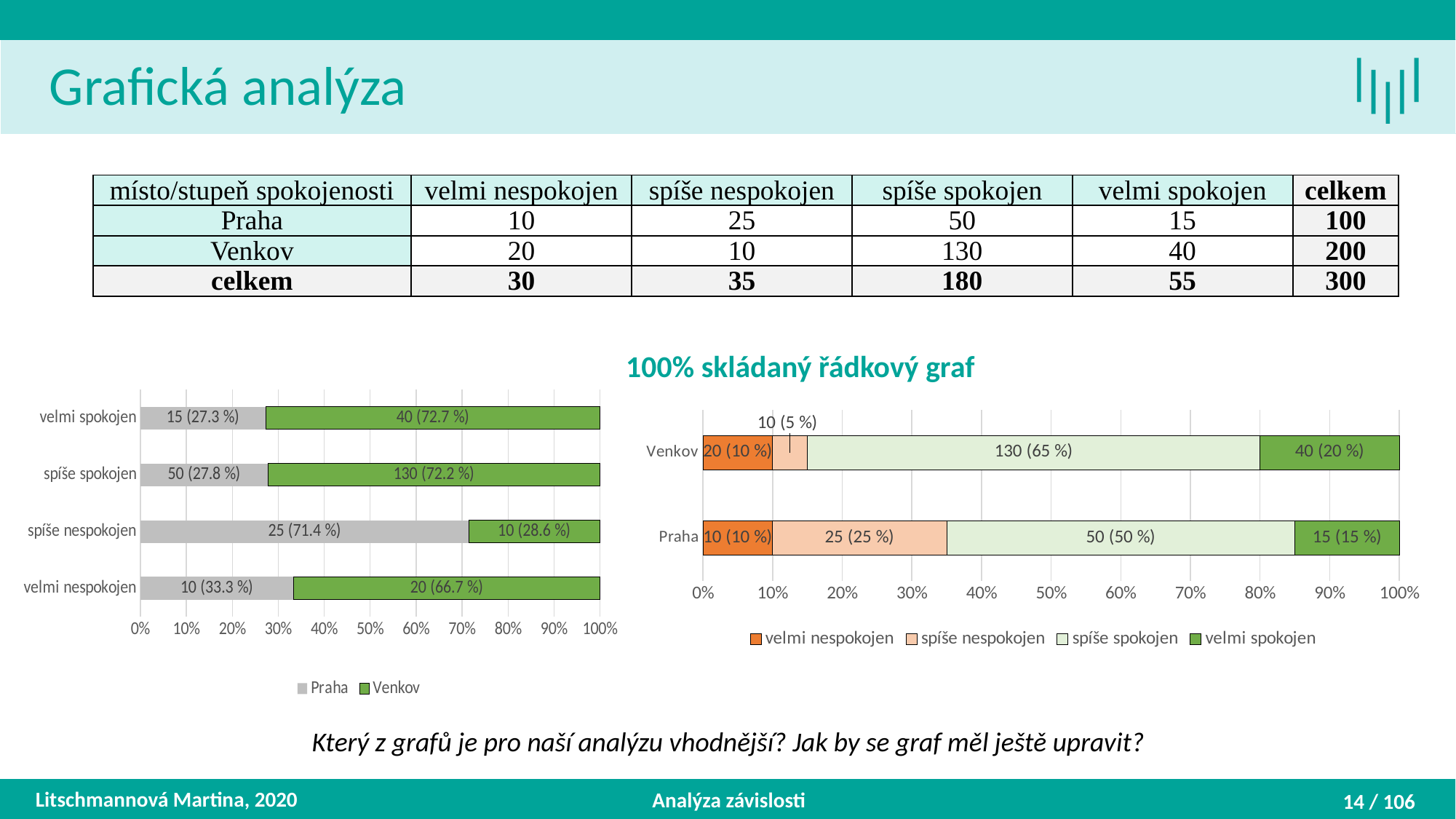
What type of chart is the chart titled '100% skládaný řádkový graf'? Stacked bar chart In the chart titled '100% skládaný řádkový graf', what is the data label for 'spíše nespokojen' in the Praha row? 25 (25 %) In the chart titled '100% skládaný řádkový graf', what is the difference in counts between 'spíše spokojen' for Venkov and 'spíše spokojen' for Praha? 80 In the left chart, how many categories are shown on the vertical axis? 4 In the chart titled '100% skládaný řádkový graf', what is the data label for 'spíše spokojen' in the Venkov row? 130 (65 %) In the chart titled '100% skládaný řádkový graf', how many series does the legend list? 4 In the left chart, what is the data label for Venkov in the 'spíše spokojen' category? 130 (72.2 %) In the left chart, which category has the largest Praha share? spíše nespokojen In the left chart, what is the data label for Praha in the 'spíše nespokojen' category? 25 (71.4 %) In the left chart, is the Praha share for 'velmi nespokojen' greater or less than 30%? greater In the chart titled '100% skládaný řádkový graf', which segment is larger in the Praha row: 'velmi spokojen' or 'spíše nespokojen'? spíše nespokojen In the left chart, how many series does the legend list? 2